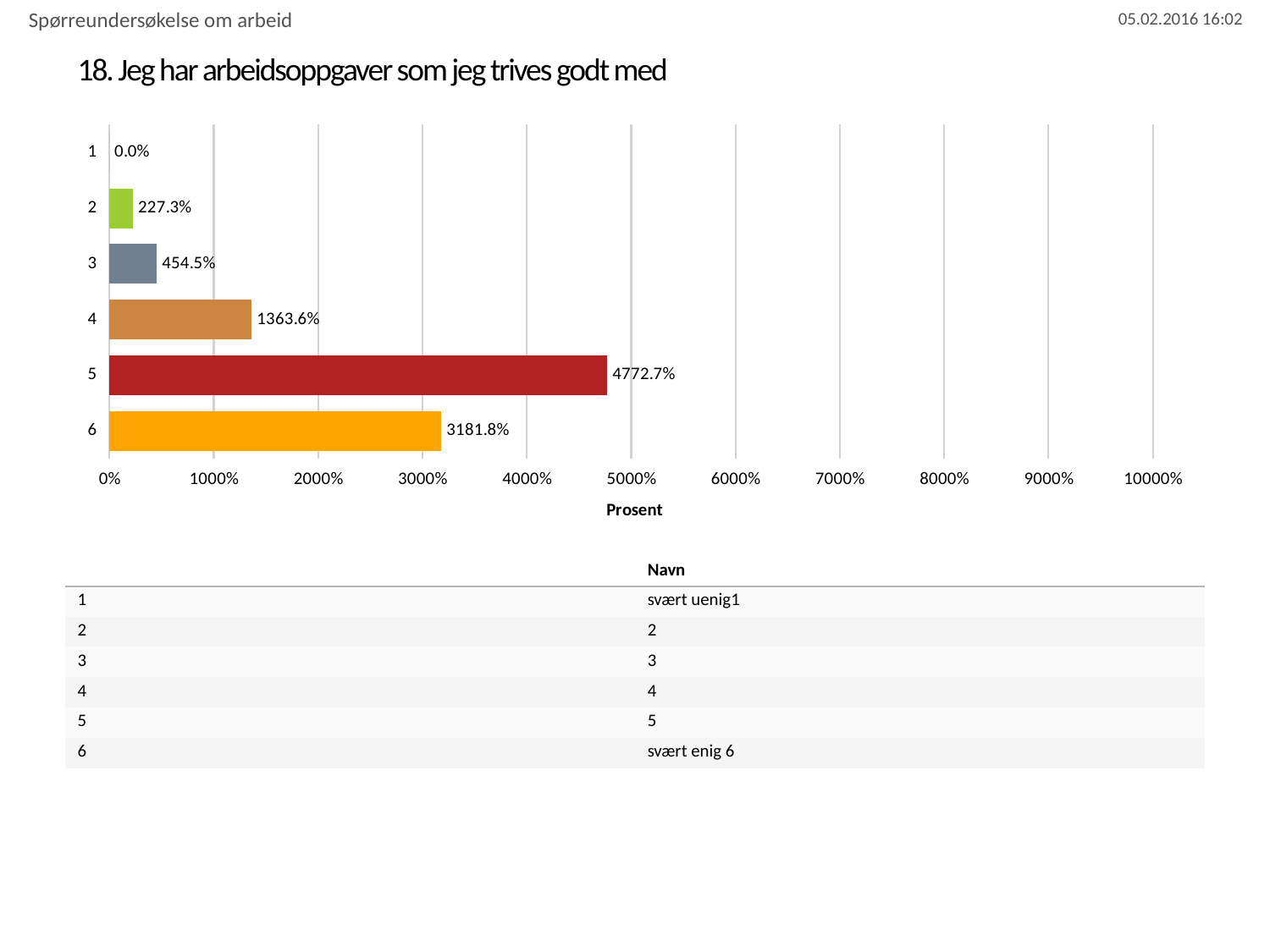
What kind of chart is shown on the slide? bar chart What is the difference between the values for category 5 and category 6? 1590.9% What is the value for category 4? 1363.6% Which category has the lowest value? 1 What is the label of the horizontal axis? Prosent Which category has the highest value? 5 Is the value for category 5 greater or less than 4000%? greater What is the value for category 5? 4772.7% What is the value for category 2? 227.3% How many categories are shown in the chart? 6 Which is larger, the value for category 4 or the value for category 6? 6 What is the difference between the values for category 3 and category 2? 227.2%